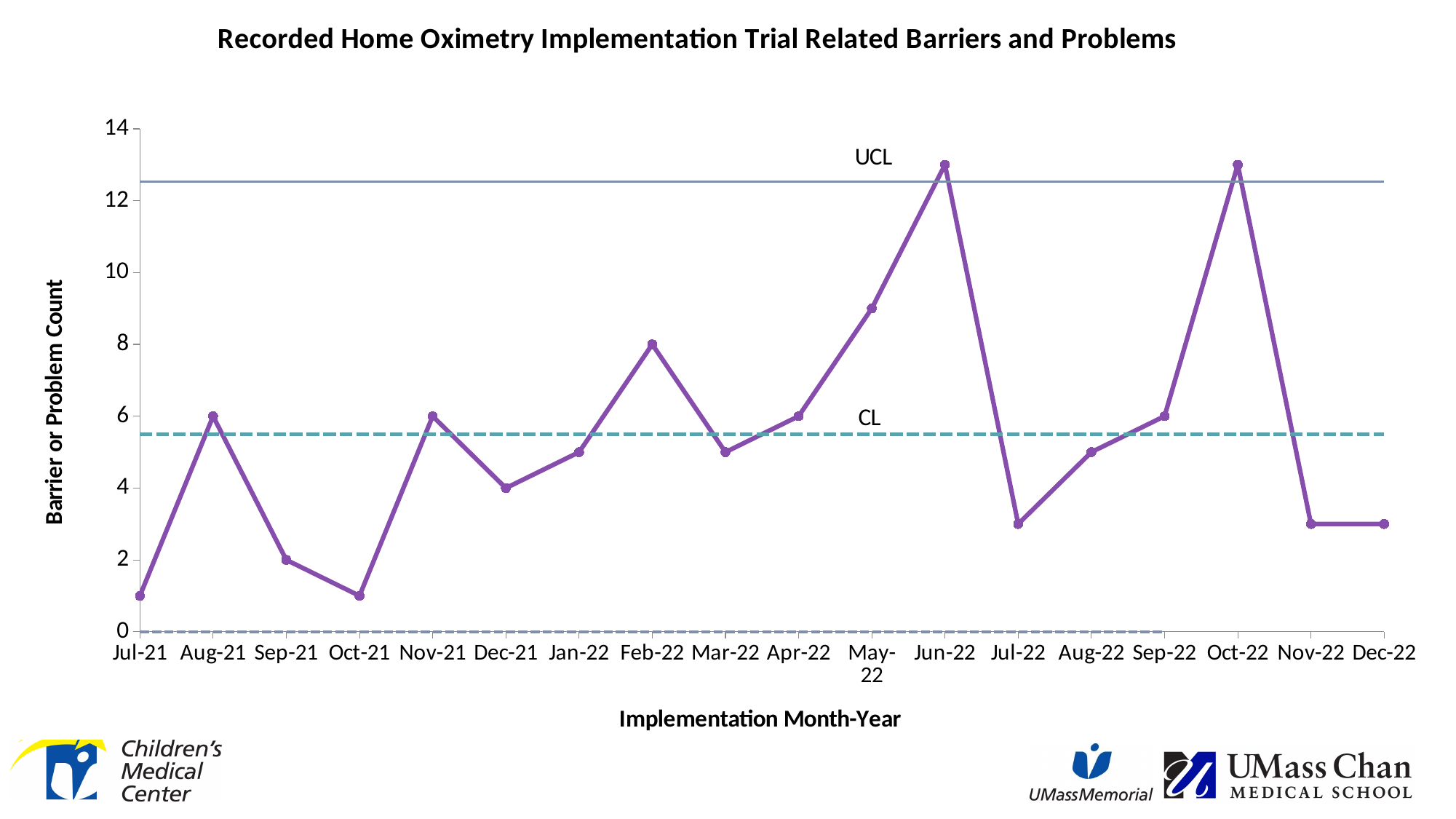
Is the value for May-22 greater or less than 8? greater Which has a higher Barrier or Problem Count, Feb-22 or Dec-21? Feb-22 What is the title of the y axis? Barrier or Problem Count How many months are plotted on the x axis? 18 What is the difference between the Barrier or Problem Count for Feb-22 and Dec-21? 4 What type of chart is shown on the slide? Line chart What is the Barrier or Problem Count for Dec-21? 4 What is the Barrier or Problem Count for Aug-21? 6 What is the Barrier or Problem Count for Sep-21? 2 Is the value for Jul-22 greater or less than 4? less What is the Barrier or Problem Count for Feb-22? 8 Is the value for Jun-22 greater or less than 12? greater